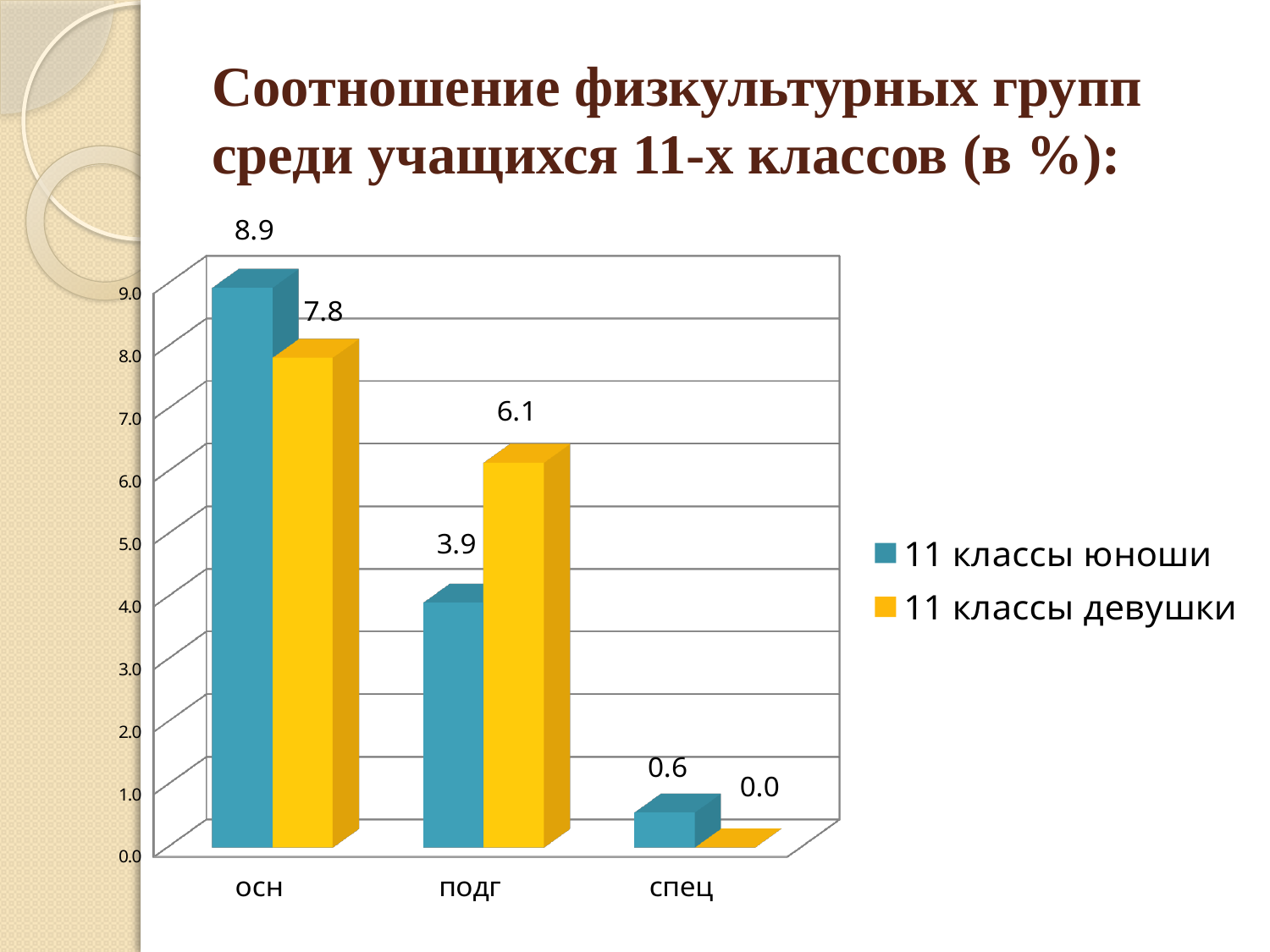
Which category has the highest value for '11 классы юноши'? осн How many series does the legend list? 2 What kind of chart is shown on the slide? bar chart Which category has the lowest value for '11 классы девушки'? спец How many categories are shown on the x axis? 3 What is the value for '11 классы девушки' in the 'подг' category? 6.1 What is the difference between the '11 классы девушки' and '11 классы юноши' values in the 'подг' category? 2.2 In the 'подг' category, which series has the larger value: '11 классы юноши' or '11 классы девушки'? 11 классы девушки What is the value for '11 классы юноши' in the 'осн' category? 8.9 What is the difference between the '11 классы юноши' and '11 классы девушки' values in the 'осн' category? 1.1 What colour are the bars for '11 классы девушки'? yellow What is the value for '11 классы девушки' in the 'спец' category? 0.0